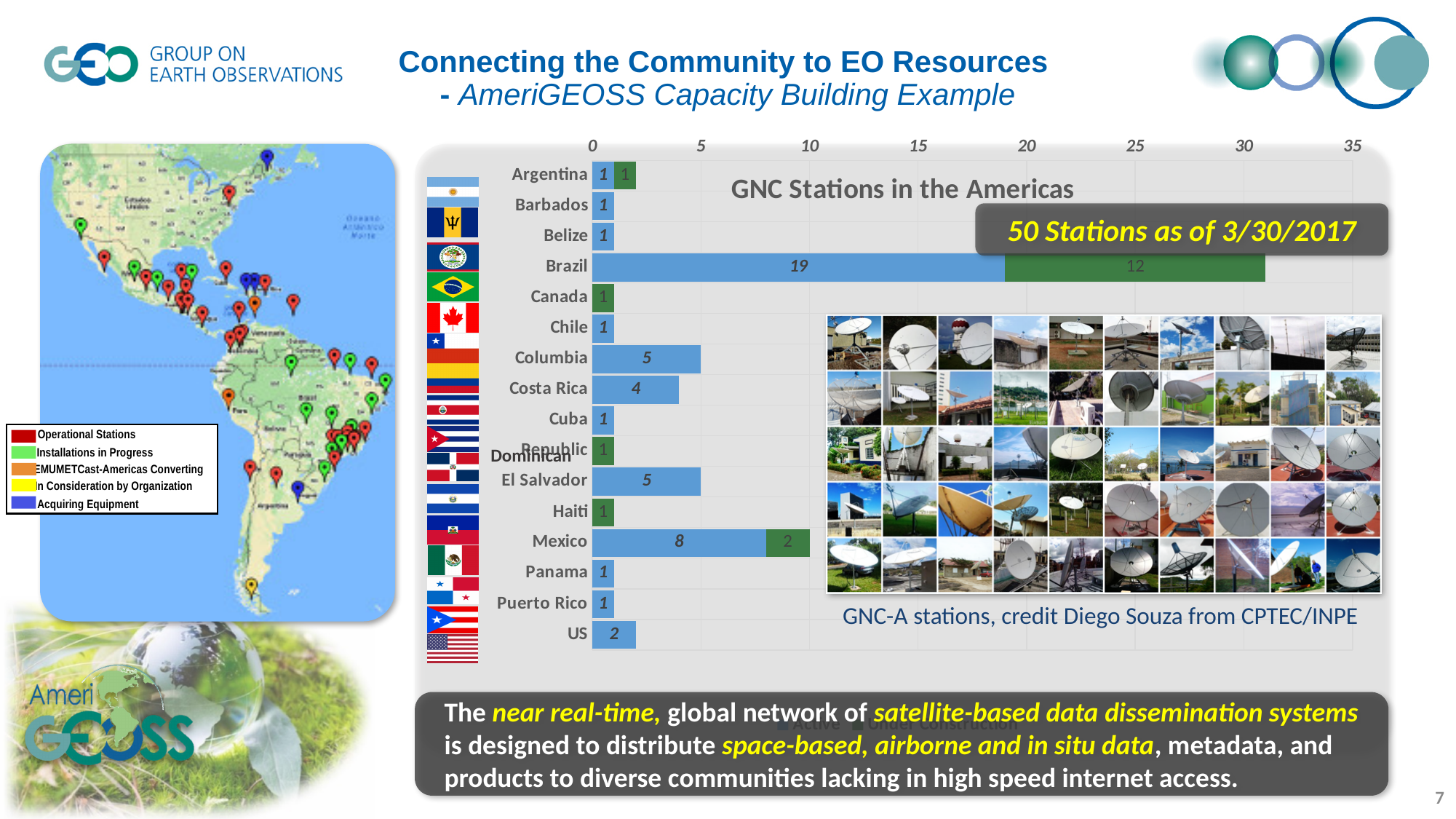
In the "GNC Stations in the Americas" chart, which has a larger value, Columbia or US? Columbia What kind of chart is the "GNC Stations in the Americas" chart? bar chart How many countries are listed on the y axis of the "GNC Stations in the Americas" chart? 16 In the "GNC Stations in the Americas" chart, what is the total of the stacked bar for Brazil? 31 In the "GNC Stations in the Americas" chart, what is the value of the green segment for Brazil? 12 In the "GNC Stations in the Americas" chart, what is the difference between the values for Columbia and Costa Rica? 1 Which country has the longest bar in the "GNC Stations in the Americas" chart? Brazil In the "GNC Stations in the Americas" chart, is the total bar length for Mexico greater or less than 5? greater What is the title of the bar chart on the slide? GNC Stations in the Americas In the "GNC Stations in the Americas" chart, what is the total of the stacked bar for Mexico? 10 In the "GNC Stations in the Americas" chart, what is the value of the blue segment for Brazil? 19 In the "GNC Stations in the Americas" chart, what is the value of the blue segment for Mexico? 8